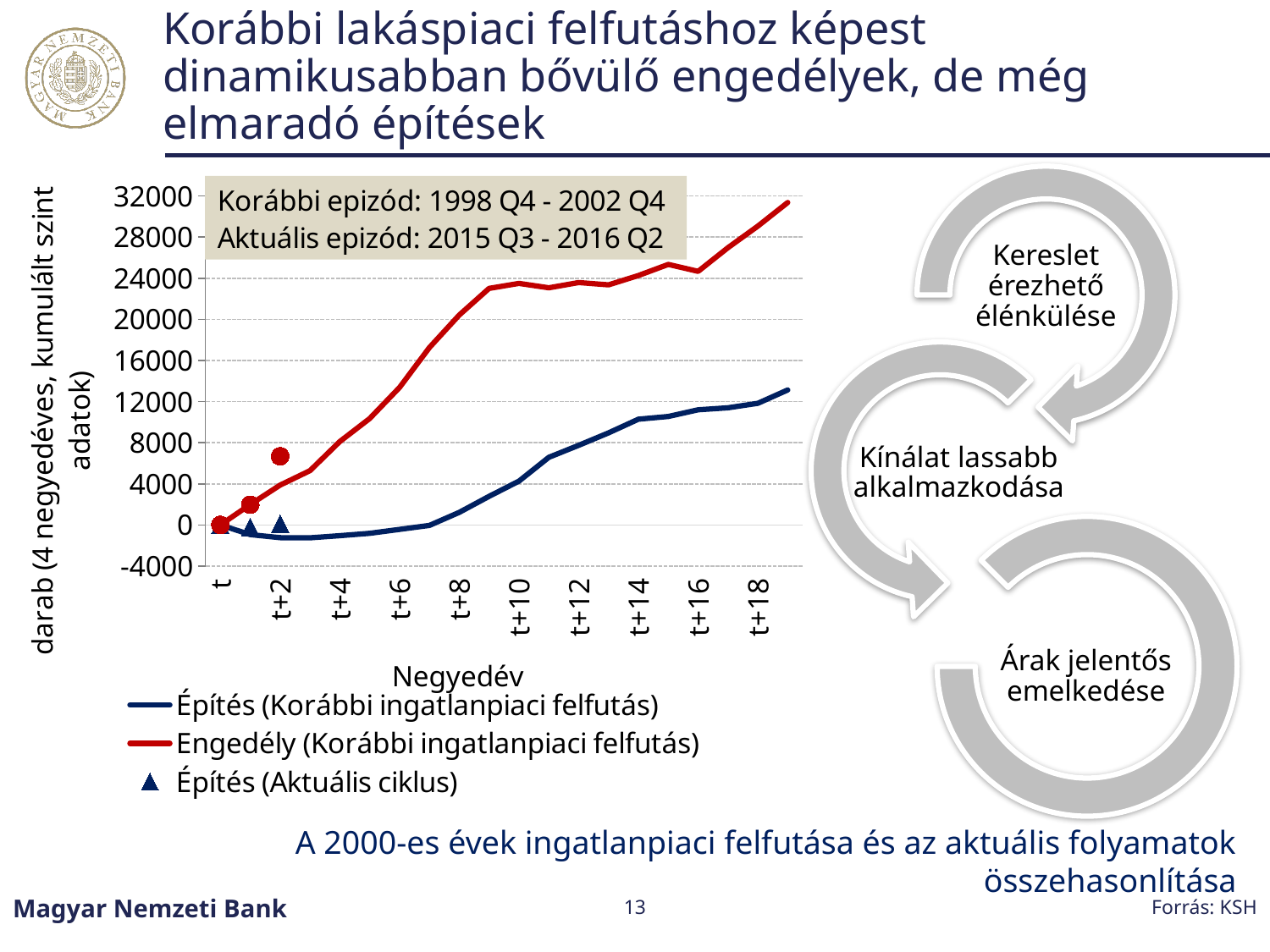
How many series does the chart legend list? 3 Does the Engedély (Korábbi ingatlanpiaci felfutás) line rise or fall overall from t to t+19? rise According to the text box in the chart, what period is the 'Korábbi epizód'? 1998 Q4 - 2002 Q4 How many tick labels are shown on the x axis of the chart? 10 At t+10, which is larger: Engedély (Korábbi ingatlanpiaci felfutás) or Építés (Korábbi ingatlanpiaci felfutás)? Engedély (Korábbi ingatlanpiaci felfutás) What kind of chart is shown on the slide? line chart Is the value of Építés (Korábbi ingatlanpiaci felfutás) at t+4 greater or less than 0? less Is the value of Engedély (Korábbi ingatlanpiaci felfutás) at t+10 greater or less than 20000? greater Is the value of Építés (Korábbi ingatlanpiaci felfutás) at t+14 greater or less than 8000? greater Does the Építés (Korábbi ingatlanpiaci felfutás) line rise or fall between t+8 and t+18? rise What is the label of the x axis of the chart? Negyedév